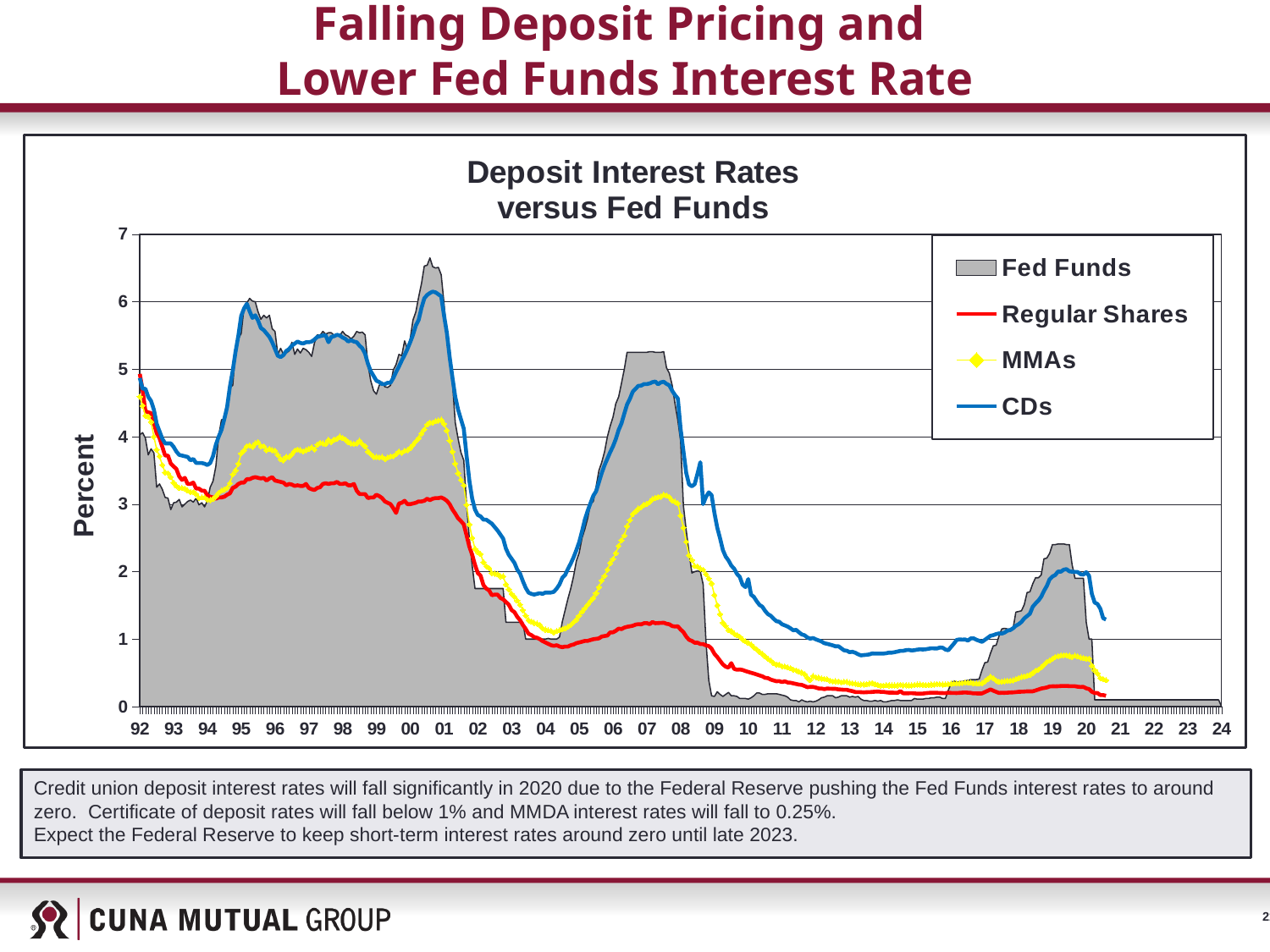
Is the value for Regular Shares in 2014 greater or less than 1? less Which series is the highest in 2007? Fed Funds What is the label on the vertical axis of the chart? Percent What is the title of the chart? Deposit Interest Rates versus Fed Funds Is the value for Fed Funds in 2007 greater or less than 4? greater Do the Fed Funds values rise or fall from 2019 to 2020? fall What kind of chart is shown on the slide? combination area and line chart In 2007, which is higher, CDs or Regular Shares? CDs How many series does the chart legend list? 4